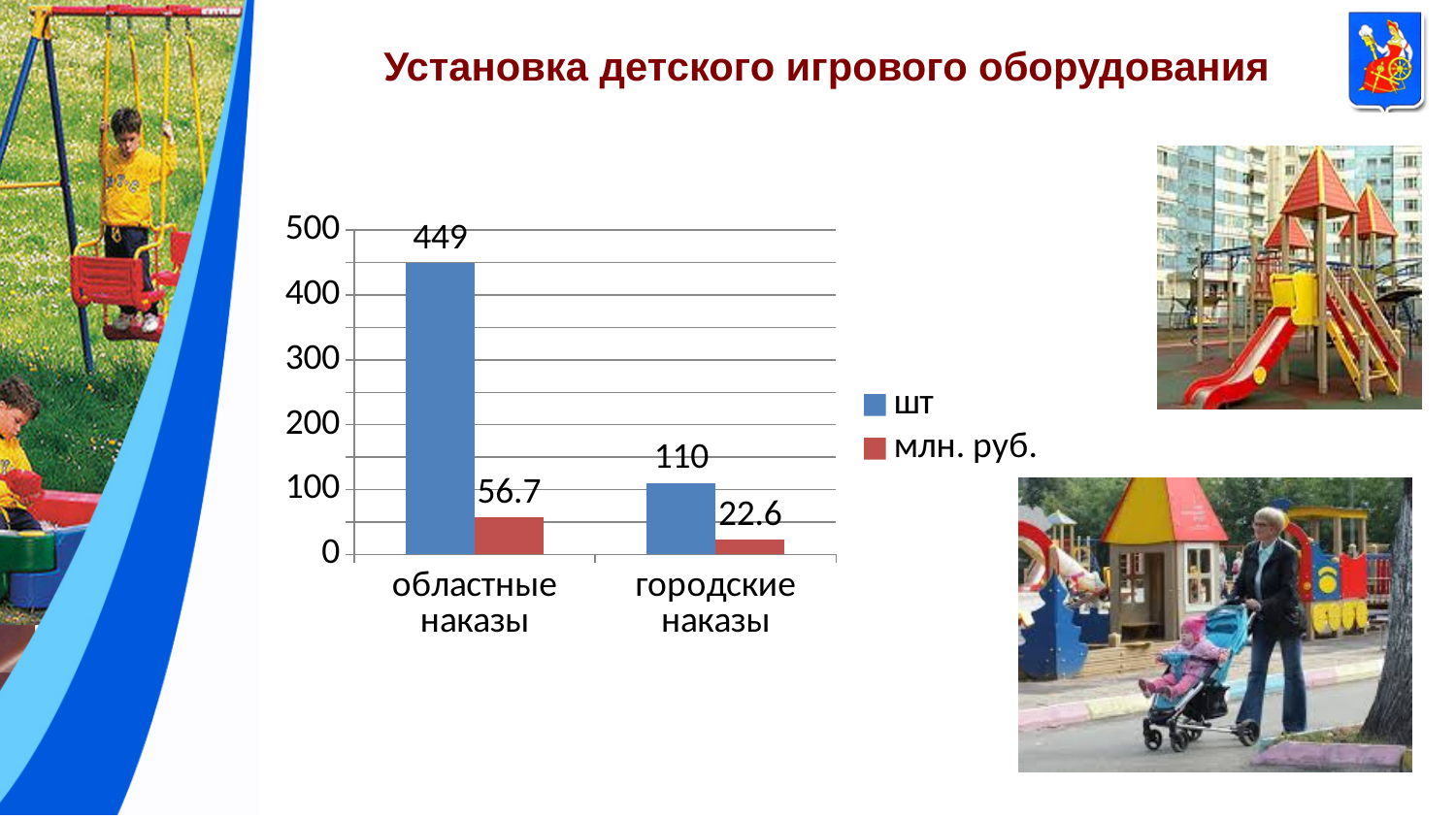
Which category has the lower млн. руб. value? городские наказы What is the value of шт for областные наказы? 449 Is the шт value for городские наказы greater or less than 200? less What is the value of млн. руб. for областные наказы? 56.7 What is the difference in млн. руб. between областные наказы and городские наказы? 34.1 What is the value of млн. руб. for городские наказы? 22.6 How many series does the legend list? 2 Which category has the higher шт value? областные наказы What is the value of шт for городские наказы? 110 How many categories are shown on the x axis? 2 What is the difference in шт between областные наказы and городские наказы? 339 What kind of chart is shown on the slide? bar chart